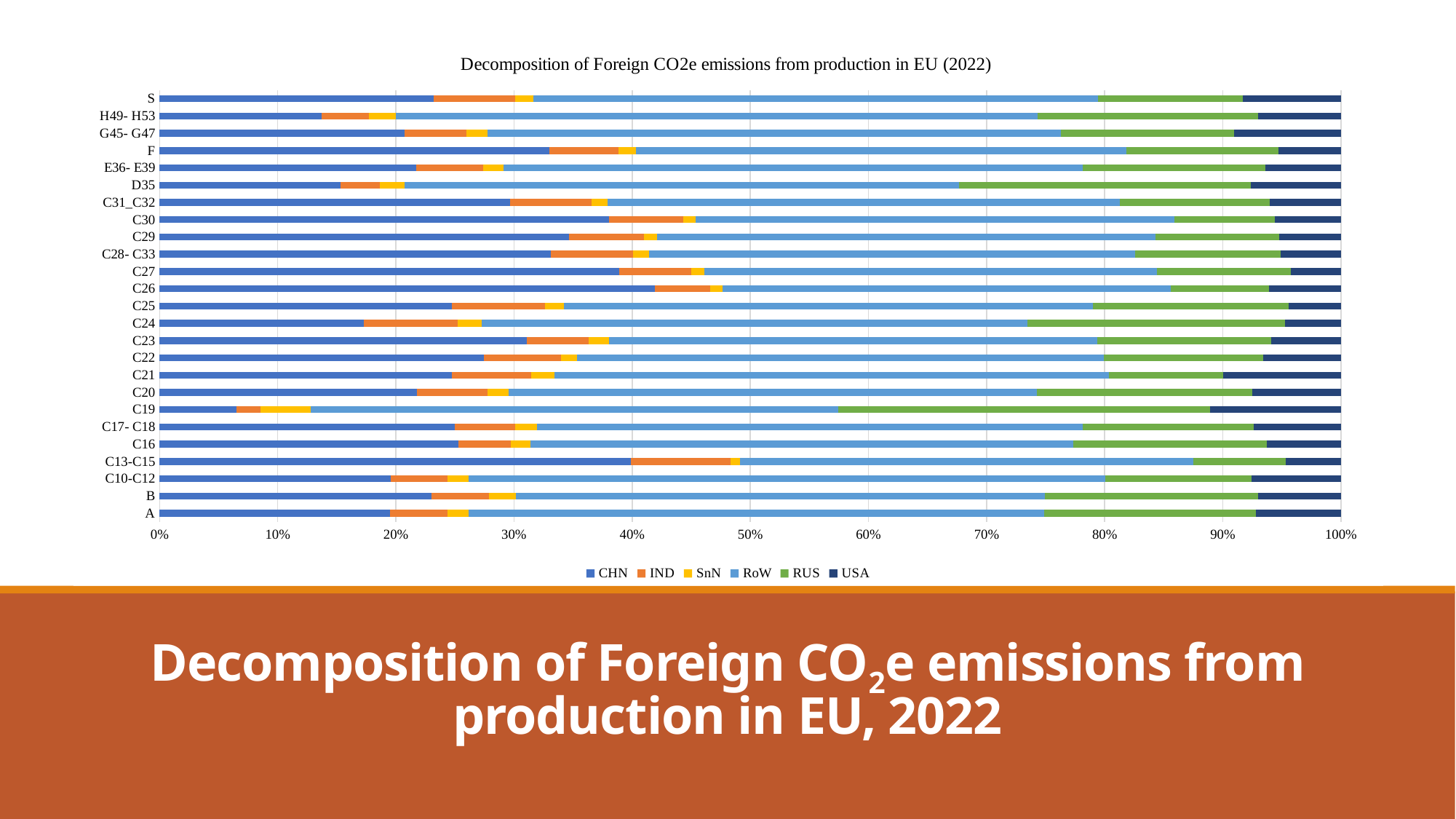
Is the CHN share for C19 greater or less than 10%? less What does each stacked bar total on the x axis? 100% Which category has the smallest CHN share? C19 Which has the larger CHN share, F or H49- H53? F Which series is shown in green in the legend? RUS What kind of chart is shown on the slide? stacked bar chart How many series does the legend list? 6 Is the CHN share for D35 greater or less than 20%? less How many categories (bars) are plotted on the chart? 25 Is the CHN share for C26 greater or less than 40%? greater Which has the larger RUS share, C19 or C26? C19 What is the title of the chart? Decomposition of Foreign CO2e emissions from production in EU (2022)